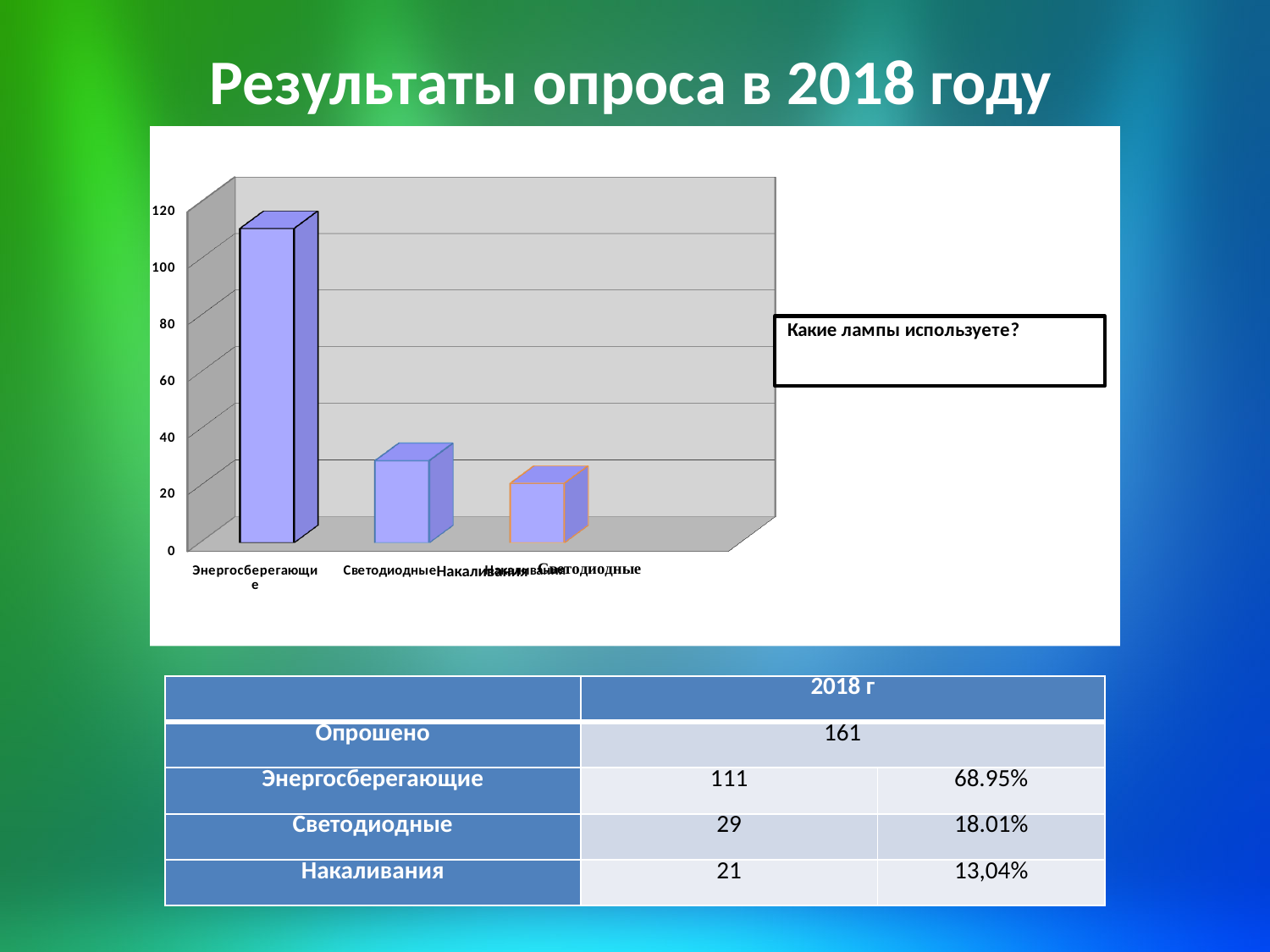
Is the value for Накаливания greater or less than 40? less What text appears in the chart's legend box? Какие лампы используете? What kind of chart is shown on the slide? bar chart Is the value for Энергосберегающие greater or less than 100? greater Which bar is taller, Светодиодные or Накаливания? Светодиодные Do the bar values rise or fall from left to right along the x axis? fall Is the value for Светодиодные greater or less than 40? less How many bars are plotted in the chart? 3 What is the highest value shown on the chart's vertical axis? 120 Which category has the tallest bar in the chart? Энергосберегающие Which category has the shortest bar in the chart? Накаливания